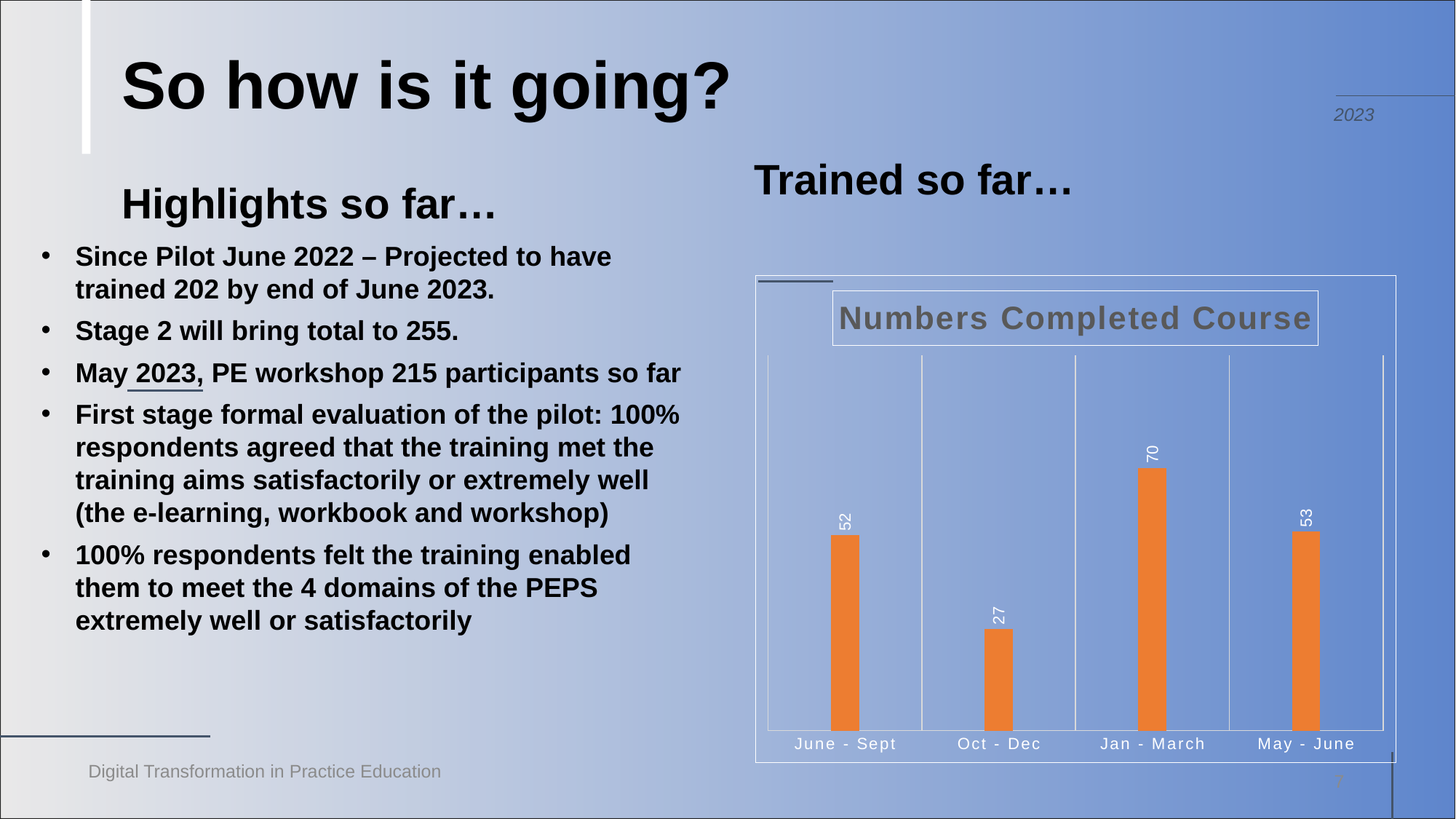
What is the title of the chart on the slide? Numbers Completed Course Which is larger, the value for June - Sept or the value for Oct - Dec? June - Sept Which period has the highest number completed in the chart? Jan - March Which period has the lowest number completed in the chart? Oct - Dec How many periods are shown on the x axis of the chart? 4 What is the value for June - Sept in the Numbers Completed Course chart? 52 What is the total of all four values in the Numbers Completed Course chart? 202 What is the value for Oct - Dec in the Numbers Completed Course chart? 27 What is the value for May - June in the Numbers Completed Course chart? 53 What kind of chart is shown on the slide? Bar chart What is the difference between the values for Jan - March and Oct - Dec? 43 What is the value for Jan - March in the Numbers Completed Course chart? 70